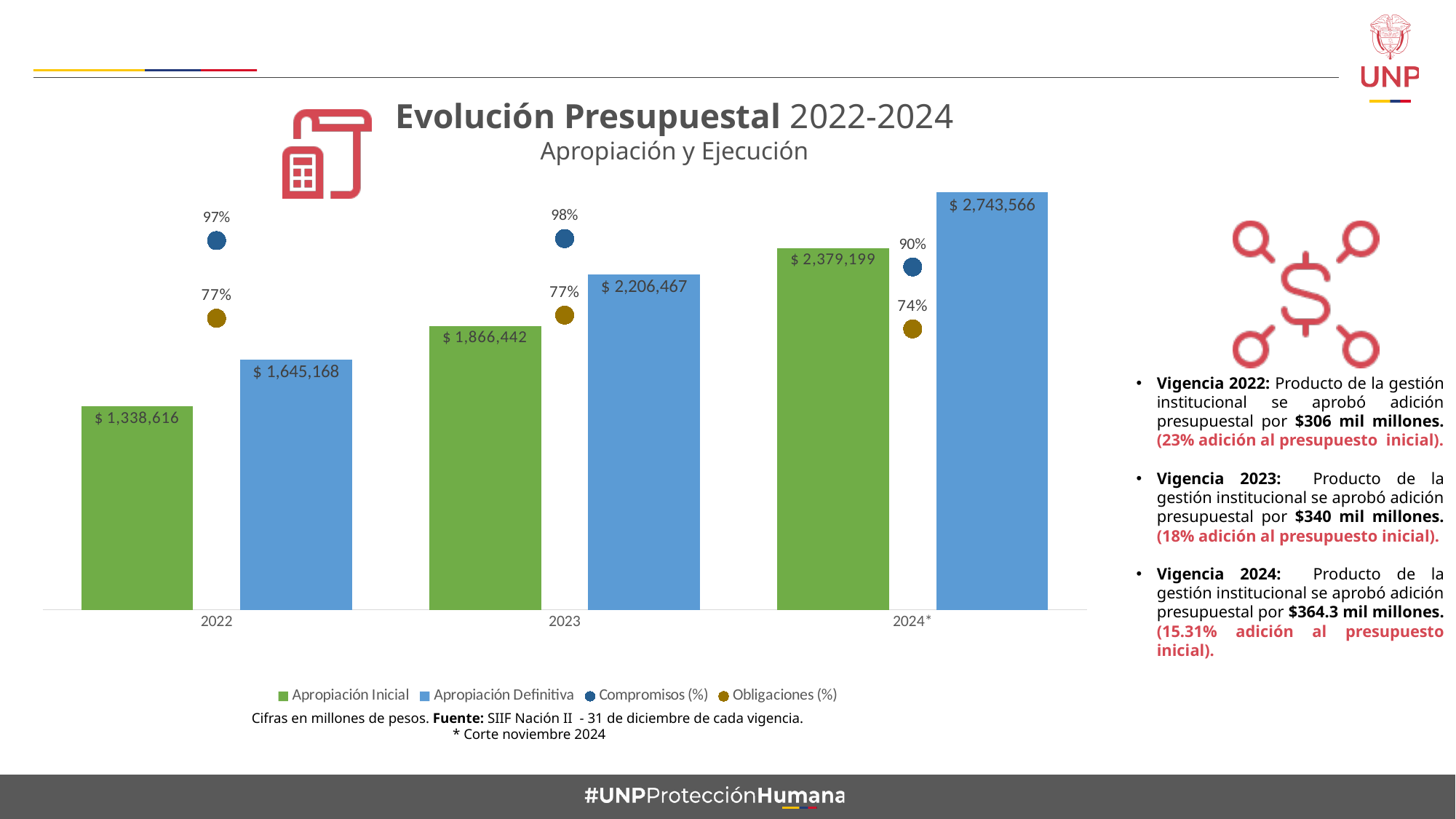
Does the Apropiación Inicial rise or fall from 2022 to 2024*? rise Which year has the highest Apropiación Definitiva? 2024* Which year has the lowest Compromisos (%)? 2024* What is the Apropiación Definitiva value for 2023? $ 2,206,467 What is the Obligaciones (%) value for 2023? 77% What is the Compromisos (%) value for 2024*? 90% What is the difference between Apropiación Definitiva and Apropiación Inicial in 2024*? $ 364,367 What is the title of the chart? Evolución Presupuestal 2022-2024 How many years are shown on the x axis of the chart? 3 How many series does the chart legend list? 4 What is the Apropiación Inicial value for 2022? $ 1,338,616 Which is larger in 2022: Apropiación Inicial or Apropiación Definitiva? Apropiación Definitiva